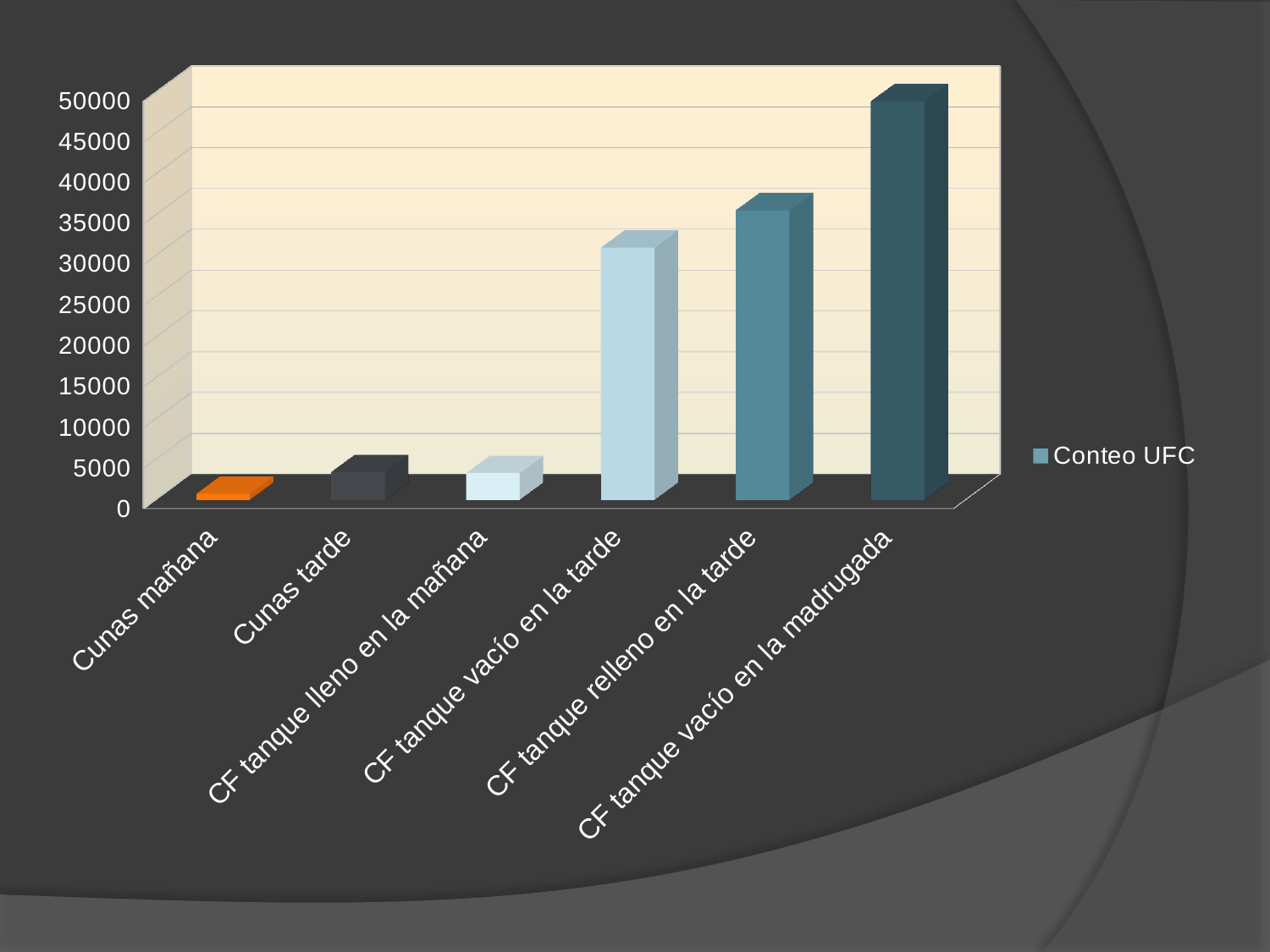
Which category has the highest Conteo UFC value? CF tanque vacío en la madrugada What kind of chart is shown on the slide? bar chart Is the value for Cunas mañana greater or less than 5000? less How many series does the legend list? 1 Is the value for CF tanque vacío en la tarde greater or less than 35000? less Which is larger, the value for CF tanque relleno en la tarde or the value for CF tanque vacío en la tarde? CF tanque relleno en la tarde Which category has the lowest Conteo UFC value? Cunas mañana Is the value for CF tanque vacío en la madrugada greater or less than 45000? greater How many categories are shown on the x axis of the chart? 6 What is the name of the series shown in the legend? Conteo UFC Do the Conteo UFC values generally rise or fall from left to right along the x axis? rise